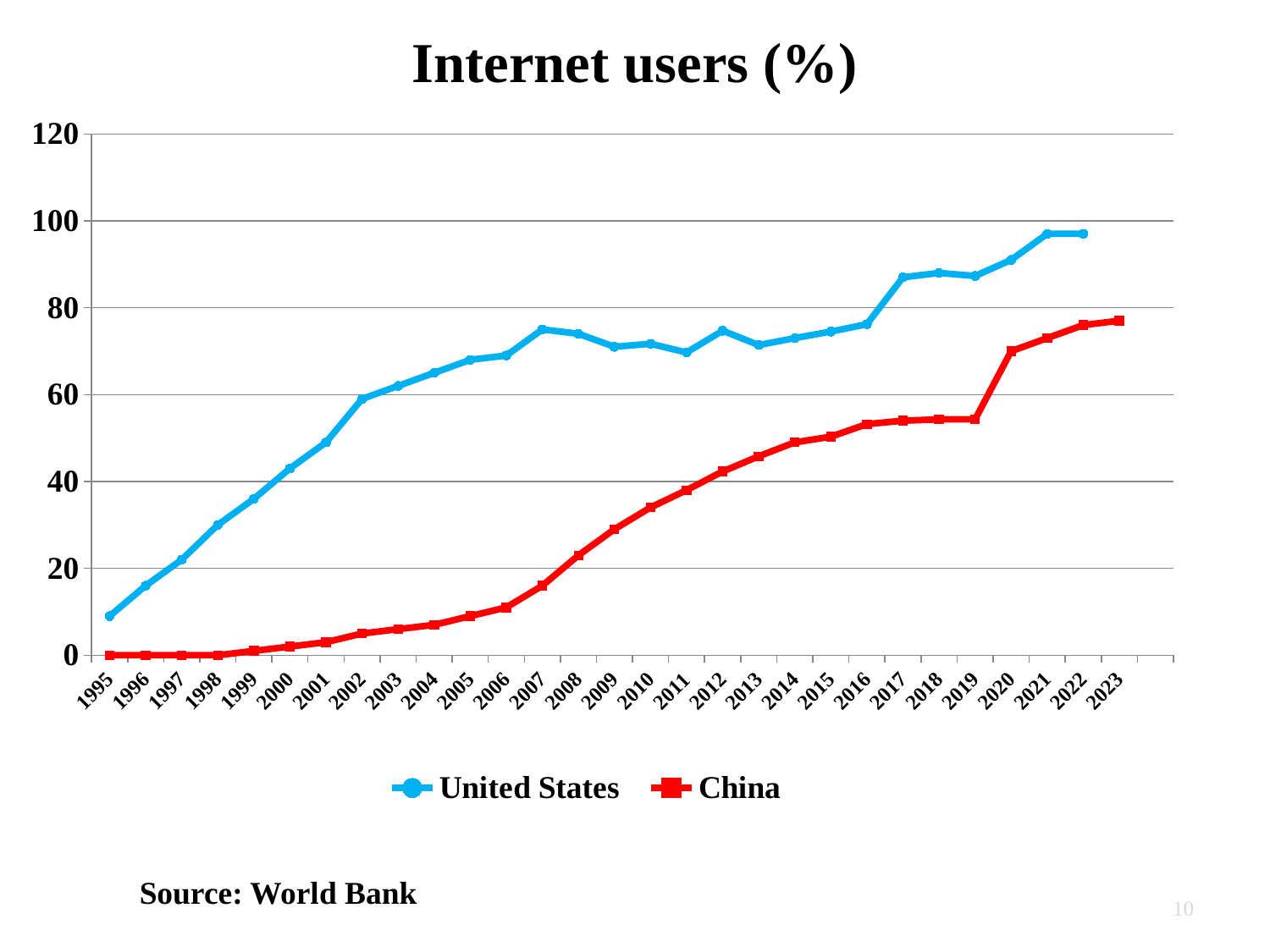
Is the value for the United States in 1995 greater or less than 20? less Which two series are shown in the legend? United States and China In which year is the China series at its highest? 2023 Is the value for China in 2020 greater or less than 60? greater In 2010, which series has the higher value, United States or China? United States Is the value for the United States in 2017 greater or less than 80? greater What is the title of the chart? Internet users (%) What kind of chart is shown on the slide? line chart How many years are labelled on the x axis? 29 How many series does the legend list? 2 Does the China series generally rise or fall from 1995 to 2023? rise